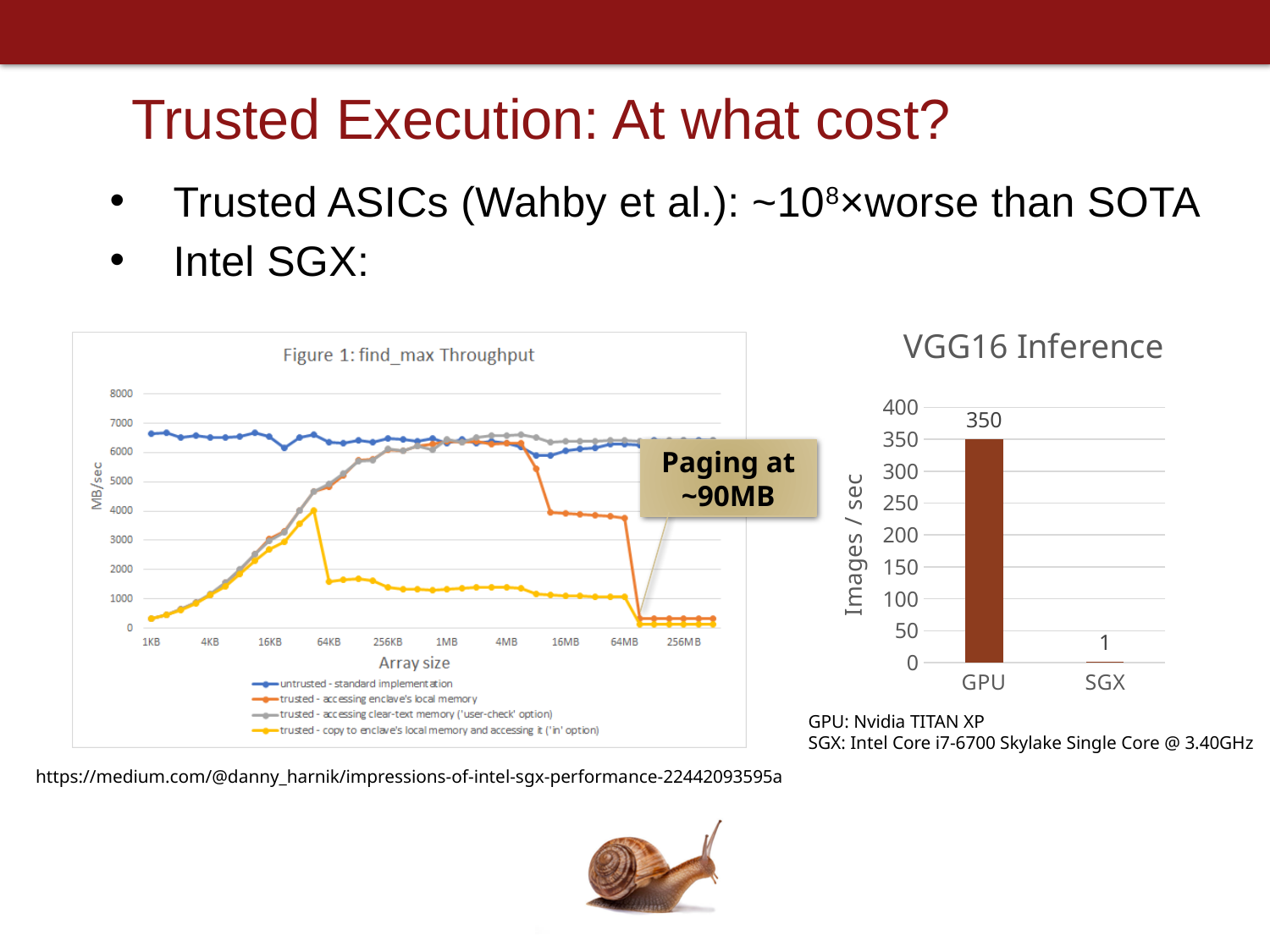
In the VGG16 Inference chart, which category has the lowest value? SGX In the VGG16 Inference chart, which category has the highest value? GPU In the Figure 1: find_max Throughput chart, how many series does the legend list? 4 In the VGG16 Inference chart, what is the value for SGX? 1 What kind of chart is the Figure 1: find_max Throughput chart? line chart In the Figure 1: find_max Throughput chart, is the value for 'untrusted - standard implementation' at 1KB greater or less than 6000? greater In the Figure 1: find_max Throughput chart, is the value for 'trusted - accessing enclave's local memory' at 256MB greater or less than 1000? less In the VGG16 Inference chart, what is the label of the y axis? Images / sec In the VGG16 Inference chart, what is the difference between the GPU and SGX values? 349 What kind of chart is the VGG16 Inference chart? bar chart In the VGG16 Inference chart, how many categories are shown on the x axis? 2 In the VGG16 Inference chart, what is the value for GPU? 350